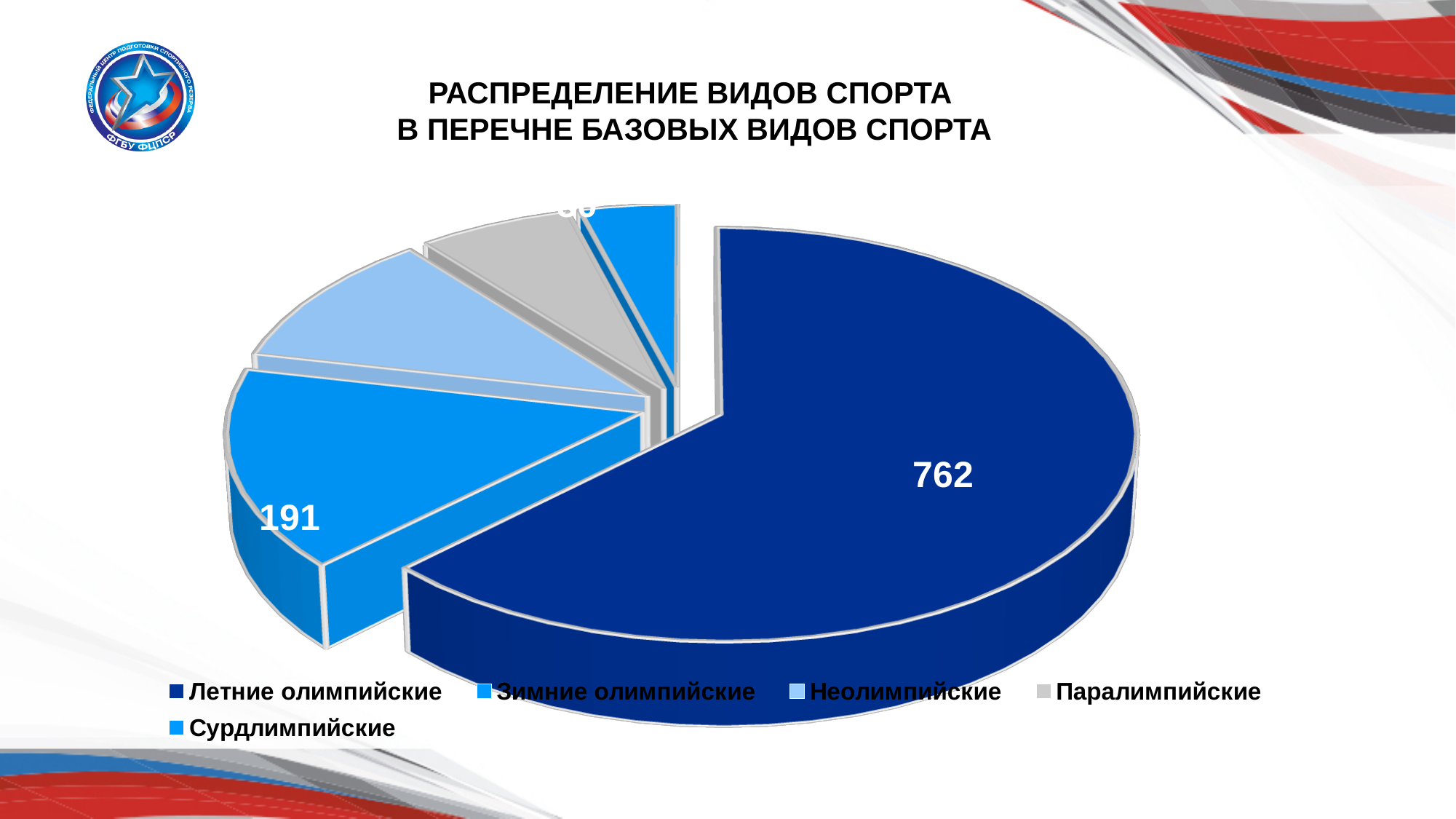
Which category has the smallest slice of the pie? Сурдлимпийские Which is larger, Летние олимпийские or Зимние олимпийские? Летние олимпийские What kind of chart is shown on the slide? Pie chart What value is shown for Зимние олимпийские? 191 What is the title of the chart? РАСПРЕДЕЛЕНИЕ ВИДОВ СПОРТА В ПЕРЕЧНЕ БАЗОВЫХ ВИДОВ СПОРТА What value is shown for Летние олимпийские? 762 How many entries does the legend list? 5 What is the difference between the values for Летние олимпийские and Зимние олимпийские? 571 Which category has the largest slice of the pie? Летние олимпийские What colour represents Паралимпийские in the chart? Grey How many categories does the pie chart show? 5